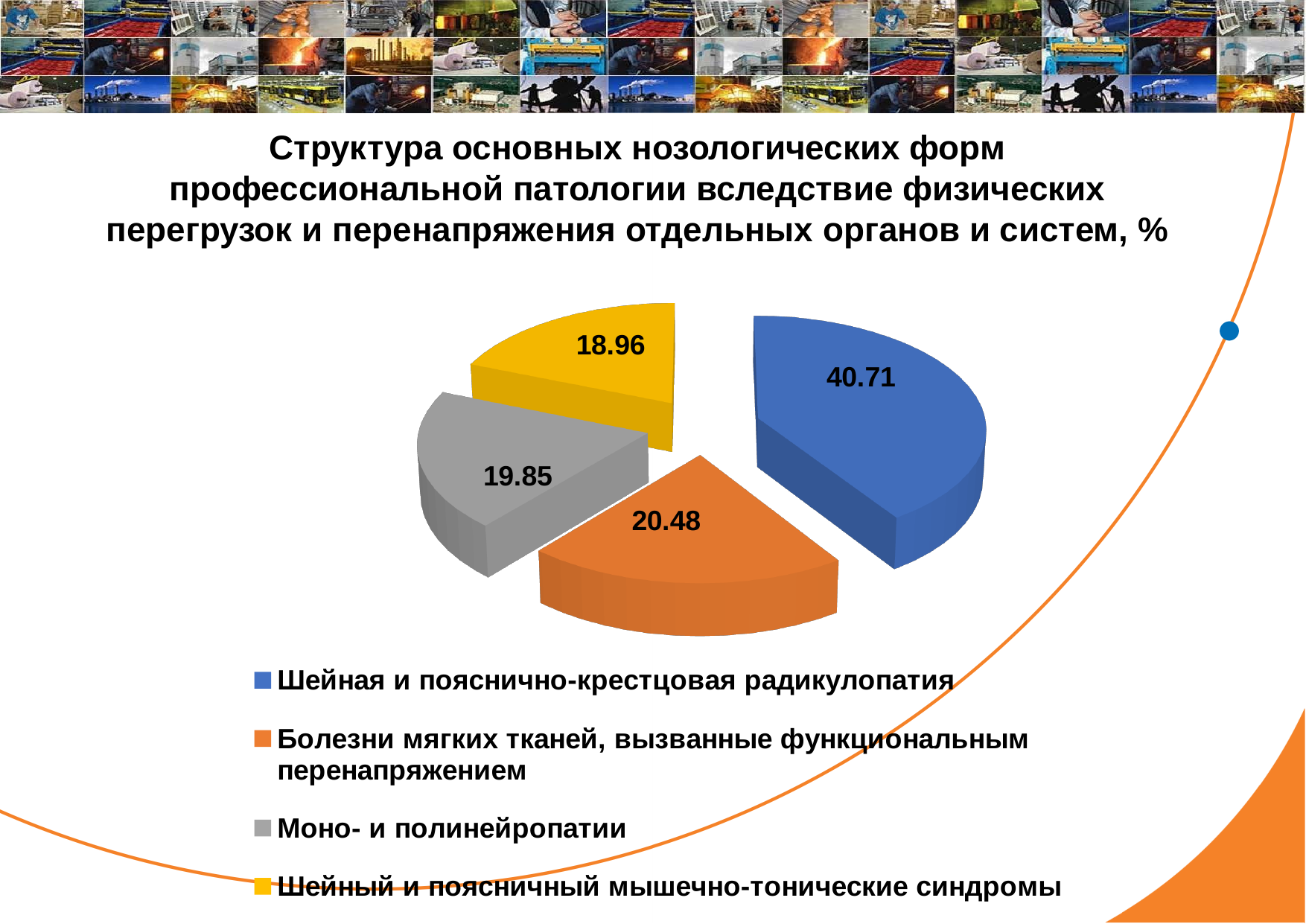
What type of chart is shown on the slide? pie chart What is the difference between the values for Шейная и пояснично-крестцовая радикулопатия and Болезни мягких тканей, вызванные функциональным перенапряжением? 20.23 What is the value for Шейная и пояснично-крестцовая радикулопатия? 40.71 Which category has the largest share of the pie? Шейная и пояснично-крестцовая радикулопатия What is the value for Шейный и поясничный мышечно-тонические синдромы? 18.96 What colour is the slice for Моно- и полинейропатии? grey Which is larger: the value for Моно- и полинейропатии or the value for Шейный и поясничный мышечно-тонические синдромы? Моно- и полинейропатии What is the value for Болезни мягких тканей, вызванные функциональным перенапряжением? 20.48 Which category has the smallest share of the pie? Шейный и поясничный мышечно-тонические синдромы How many slices does the pie chart have? 4 Which category is shown in orange in the legend? Болезни мягких тканей, вызванные функциональным перенапряжением What is the value for Моно- и полинейропатии? 19.85